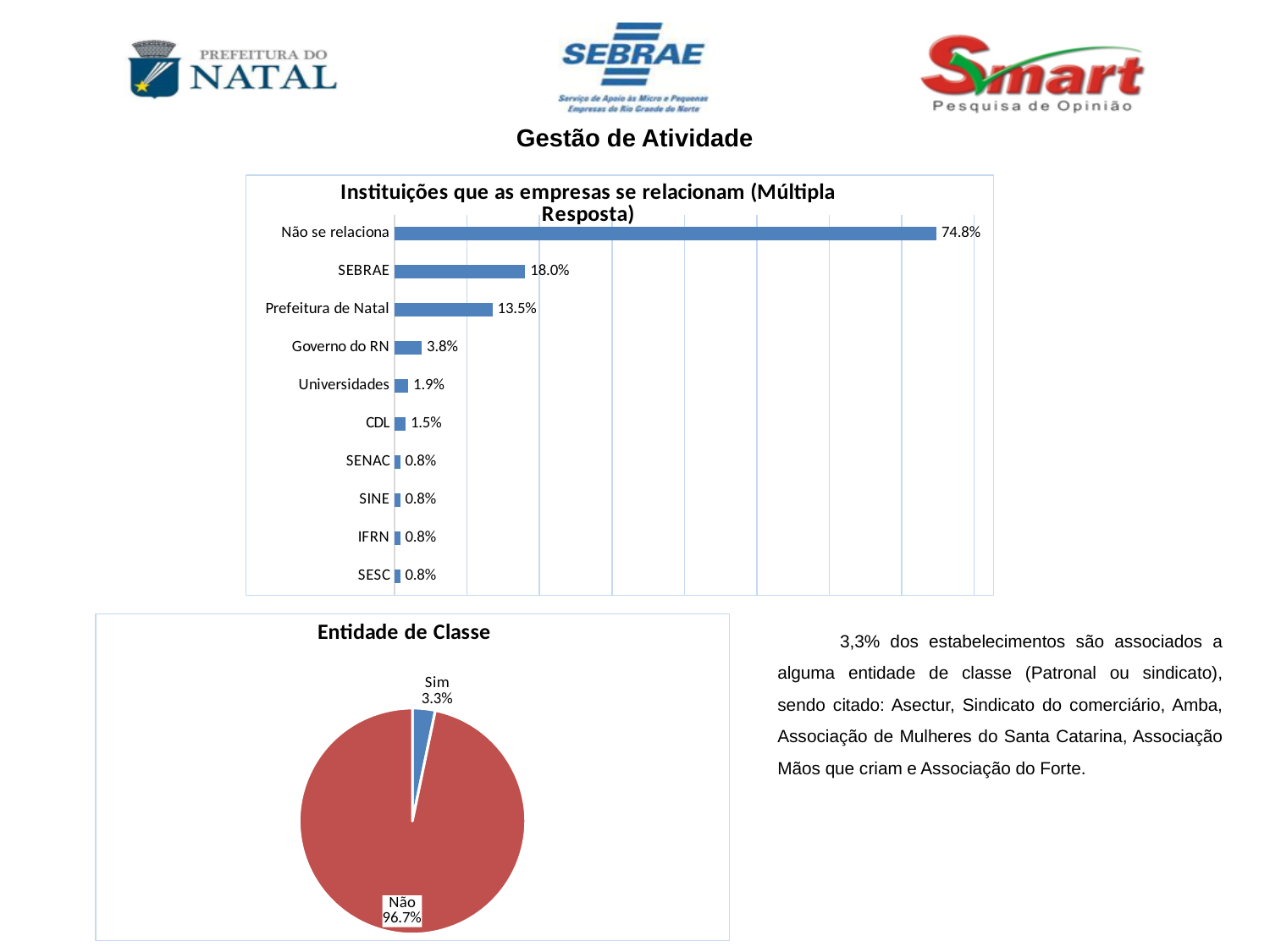
In the 'Instituições que as empresas se relacionam' chart, what is the value for Prefeitura de Natal? 13.5% In the 'Instituições que as empresas se relacionam' chart, which is larger, the value for Governo do RN or the value for Universidades? Governo do RN How many categories are shown in the 'Instituições que as empresas se relacionam' chart? 10 What kind of chart is the 'Instituições que as empresas se relacionam' chart? Bar chart In the 'Instituições que as empresas se relacionam' chart, what is the value for SEBRAE? 18.0% In the 'Instituições que as empresas se relacionam' chart, which category has the highest value? Não se relaciona In the 'Instituições que as empresas se relacionam' chart, what is the value for CDL? 1.5% In the 'Instituições que as empresas se relacionam' chart, what is the difference between the values for SEBRAE and Prefeitura de Natal? 4.5% What kind of chart is the 'Entidade de Classe' chart? Pie chart In the 'Entidade de Classe' chart, what share of the pie is 'Não'? 96.7% In the 'Entidade de Classe' chart, what is the value for 'Sim'? 3.3% How many slices does the 'Entidade de Classe' pie chart have? 2